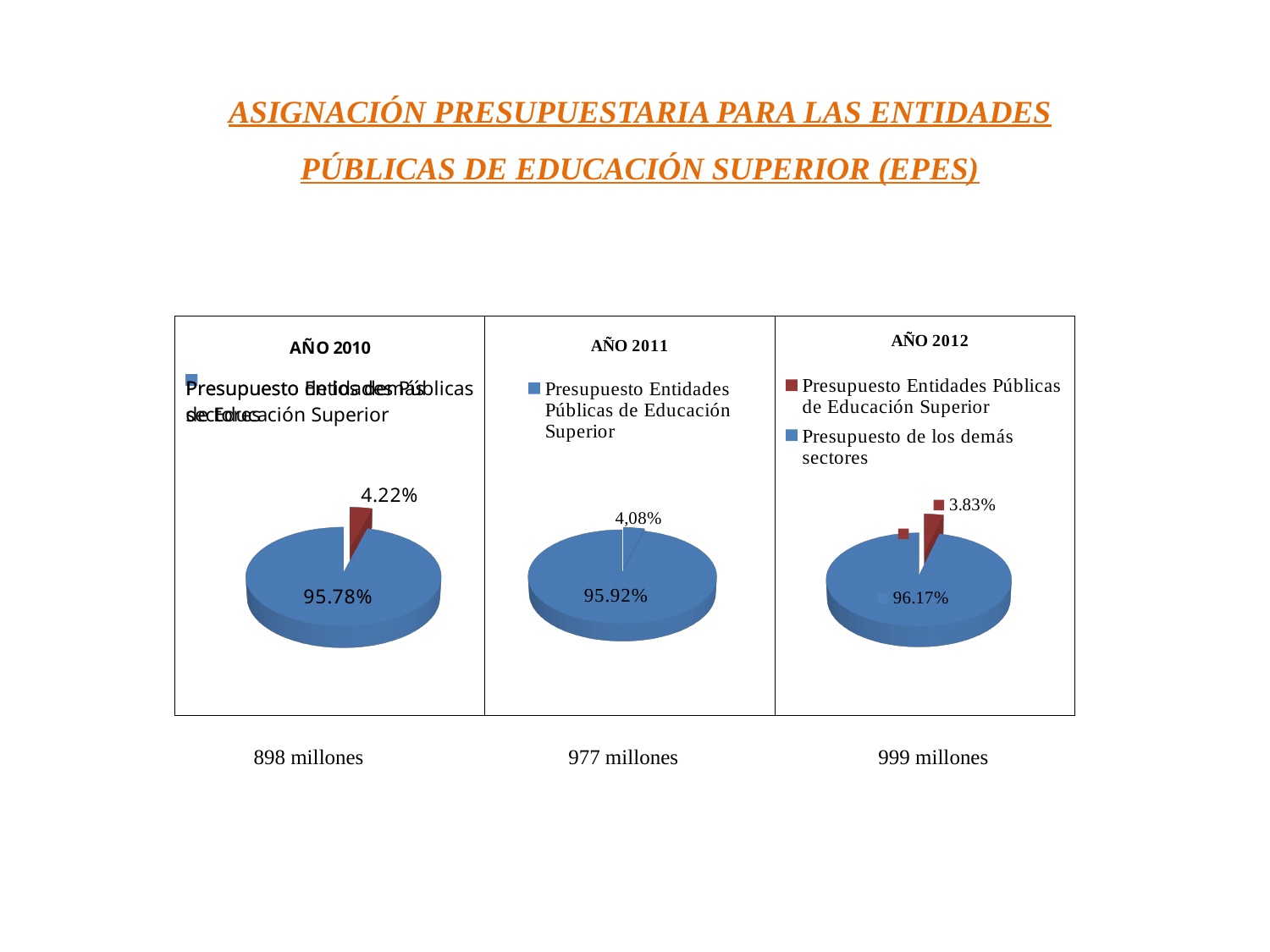
In the AÑO 2012 chart, what percentage is shown for Presupuesto Entidades Públicas de Educación Superior? 3.83% In the AÑO 2010 chart, what share of the pie is labelled for the smaller slice? 4.22% What is the title of the chart on the right of the slide? AÑO 2012 Across the three pie charts, which year shows the smallest percentage for the small red slice? AÑO 2012 In the AÑO 2012 chart, which slice is larger: Presupuesto Entidades Públicas de Educación Superior or Presupuesto de los demás sectores? Presupuesto de los demás sectores In the AÑO 2011 chart, what percentage is shown for the small slice? 4,08% In the AÑO 2010 chart, what percentage is shown on the large blue slice? 95.78% How many slices does the AÑO 2011 pie chart have? 2 In the AÑO 2012 chart, what percentage is shown for Presupuesto de los demás sectores? 96.17% What kind of chart is used for AÑO 2012? Pie chart In the AÑO 2011 chart, what percentage is shown on the large blue slice? 95.92% How many entries does the legend of the AÑO 2012 chart list? 2